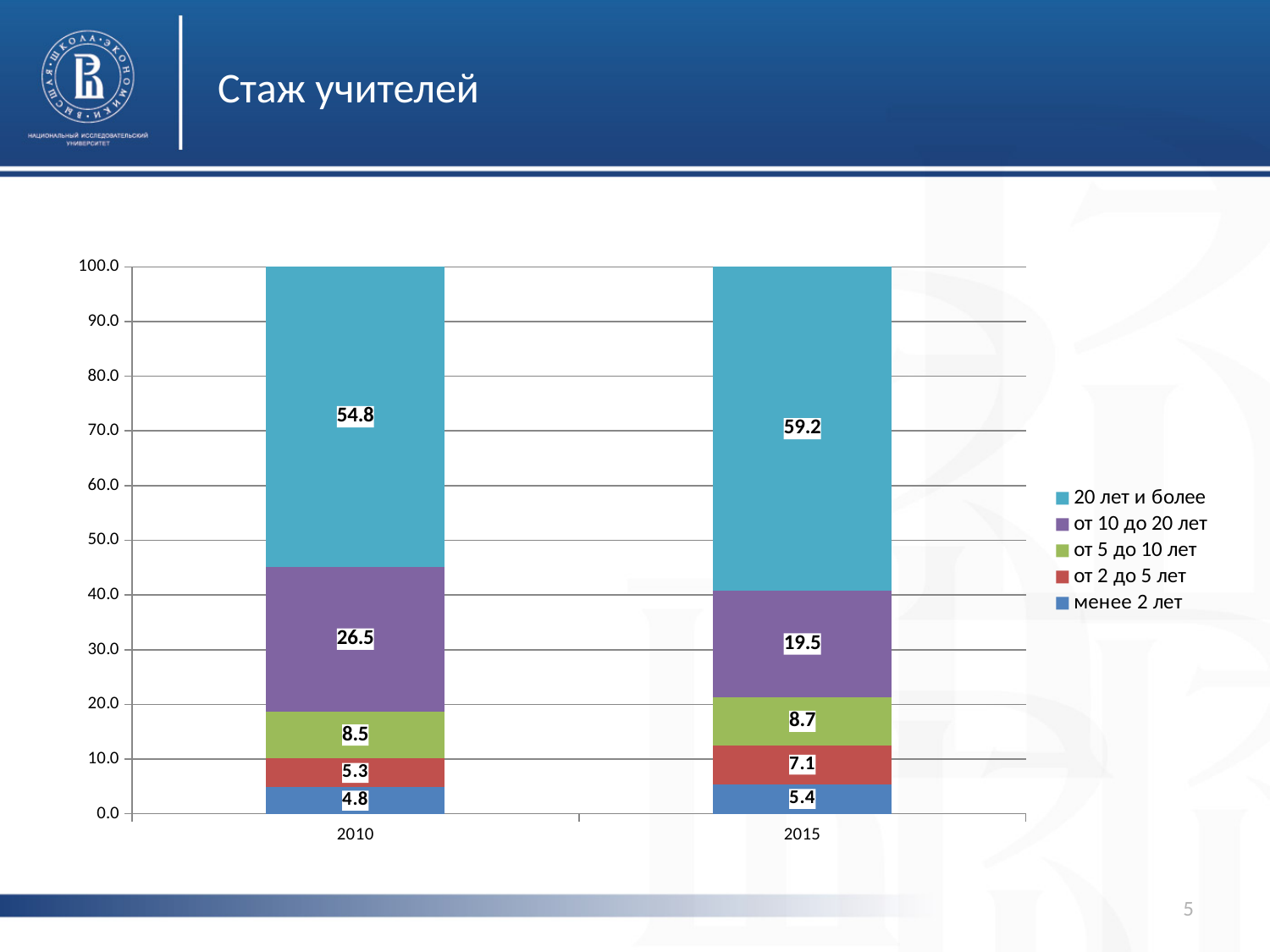
How many categories are shown on the x axis? 2 What kind of chart is shown on the slide? Stacked bar chart Which is larger: the "20 лет и более" value in 2010 or in 2015? 2015 Which series has the largest value in the 2015 bar? 20 лет и более What is the value for "от 10 до 20 лет" in 2015? 19.5 What is the value for "менее 2 лет" in 2010? 4.8 What is the difference between the "от 10 до 20 лет" values for 2010 and 2015? 7.0 How many series does the legend list? 5 What is the title of the slide containing the chart? Стаж учителей What is the value for "20 лет и более" in 2010? 54.8 What is the value for "от 2 до 5 лет" in 2015? 7.1 Which series has the smallest value in the 2010 bar? менее 2 лет